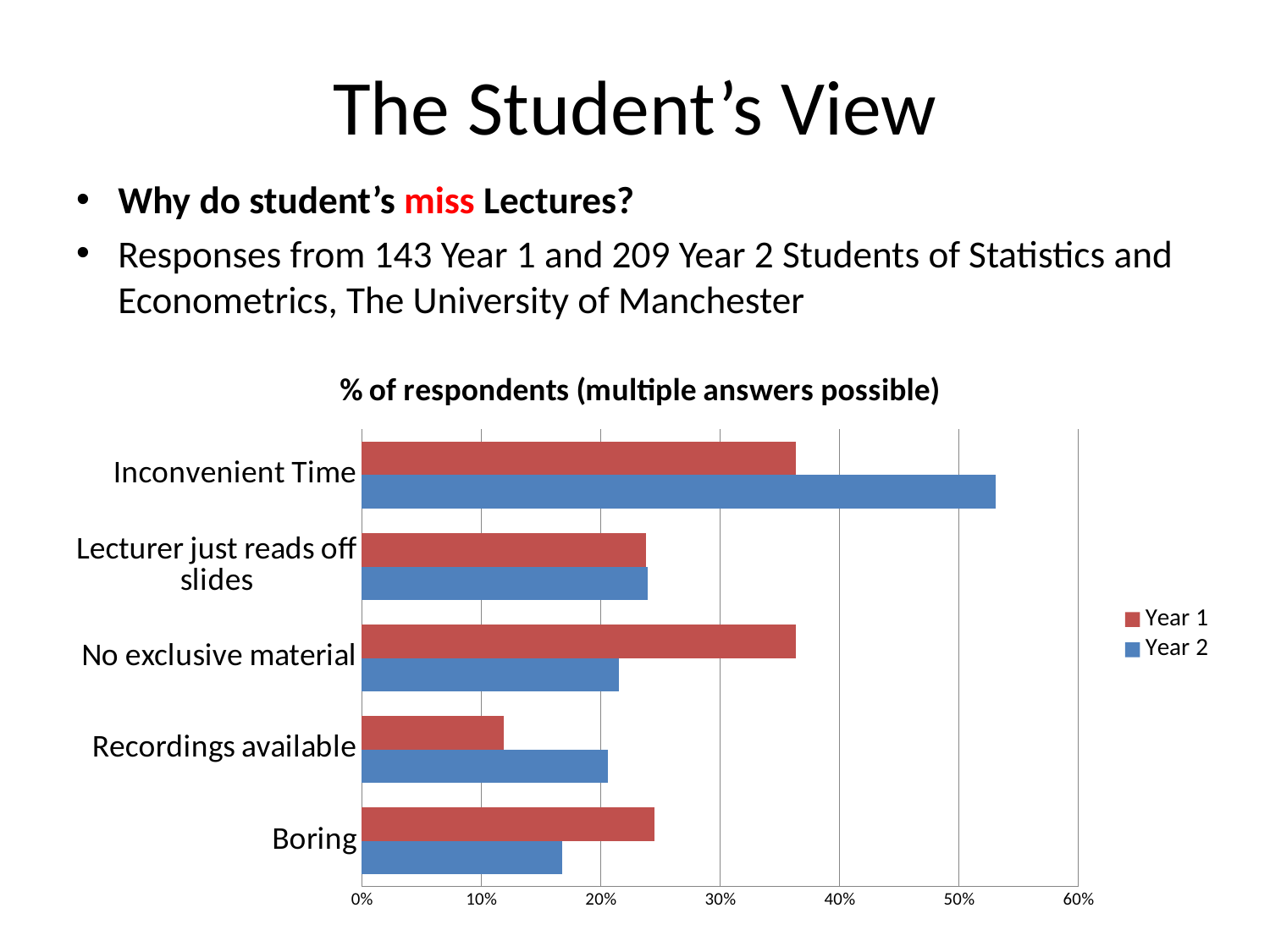
Is the Year 1 value for Recordings available greater or less than 20%? less Is the Year 2 value for Inconvenient Time greater or less than 50%? greater What is the title of the chart? % of respondents (multiple answers possible) Which reason has the highest value for Year 2? Inconvenient Time For No exclusive material, which is larger: Year 1 or Year 2? Year 1 How many reasons (categories) are plotted on the chart? 5 Is the Year 1 value for No exclusive material greater or less than 30%? greater Which reason has the lowest value for Year 1? Recordings available What kind of chart is shown on the slide? bar chart For Inconvenient Time, which is larger: Year 1 or Year 2? Year 2 How many series does the legend list? 2